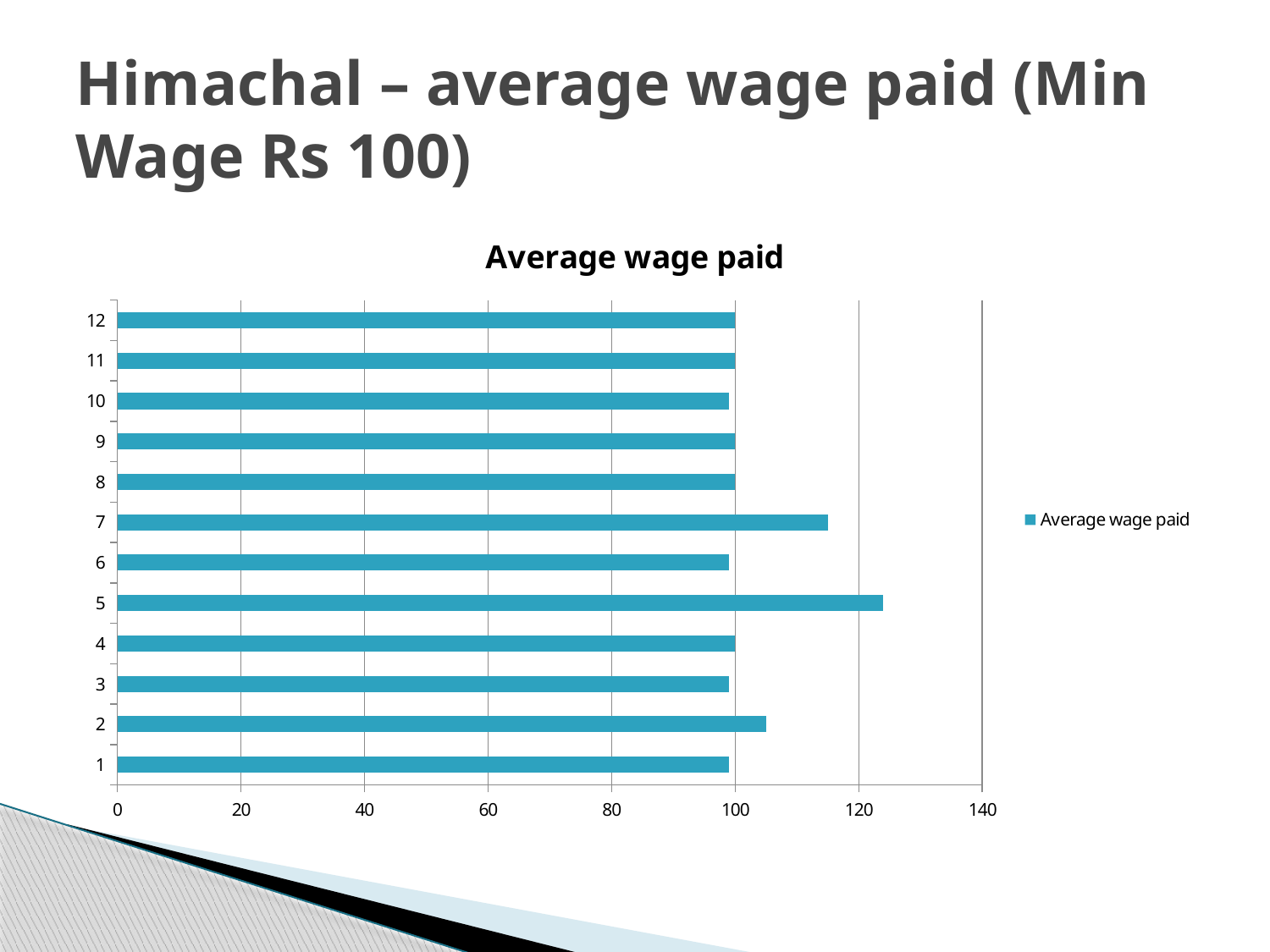
What kind of chart is shown on the slide? bar chart Is the value for category 2 greater or less than 100? greater Is the value for category 5 greater or less than 120? greater What is the title of the chart? Average wage paid Which category has the highest average wage paid? 5 Is the value for category 7 greater or less than 100? greater Which is larger, the value for category 5 or the value for category 7? 5 How many series does the legend list? 1 What is the name of the series shown in the legend? Average wage paid Which is larger, the value for category 7 or the value for category 2? 7 How many categories are plotted on the chart? 12